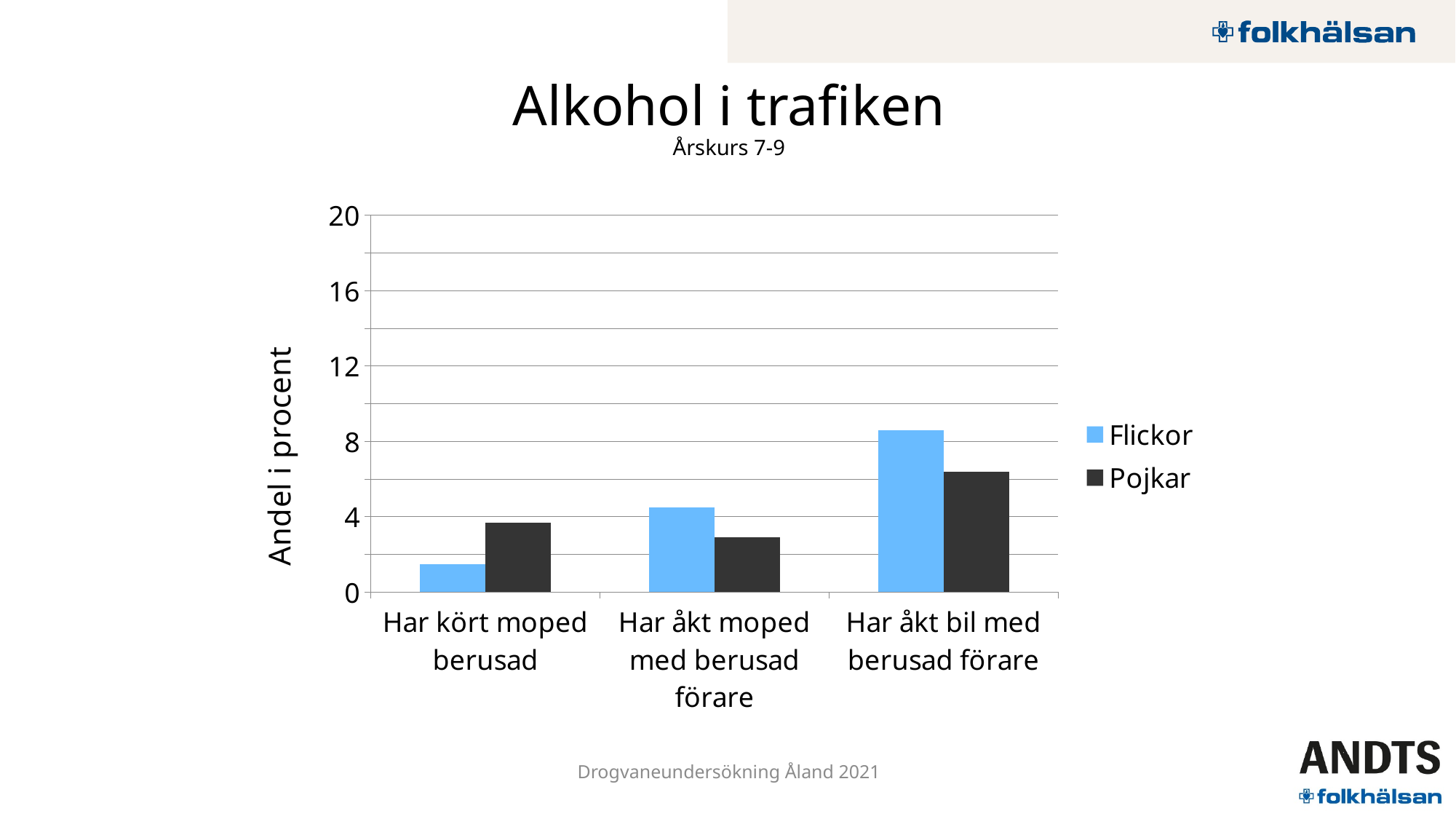
Is the value for Pojkar in 'Har åkt moped med berusad förare' greater or less than 4? less What is the title of the chart's vertical axis? Andel i procent For 'Har kört moped berusad', which series has the larger value, Flickor or Pojkar? Pojkar How many series does the chart's legend list? 2 Is the value for Pojkar in 'Har åkt bil med berusad förare' greater or less than 8? less Which category has the highest value for Flickor? Har åkt bil med berusad förare Which category has the highest value for Pojkar? Har åkt bil med berusad förare Which category has the lowest value for Flickor? Har kört moped berusad What kind of chart is shown on the slide? bar chart For 'Har åkt bil med berusad förare', which series has the larger value, Flickor or Pojkar? Flickor Is the value for Flickor in 'Har kört moped berusad' greater or less than 4? less How many categories are shown on the x axis of the chart? 3